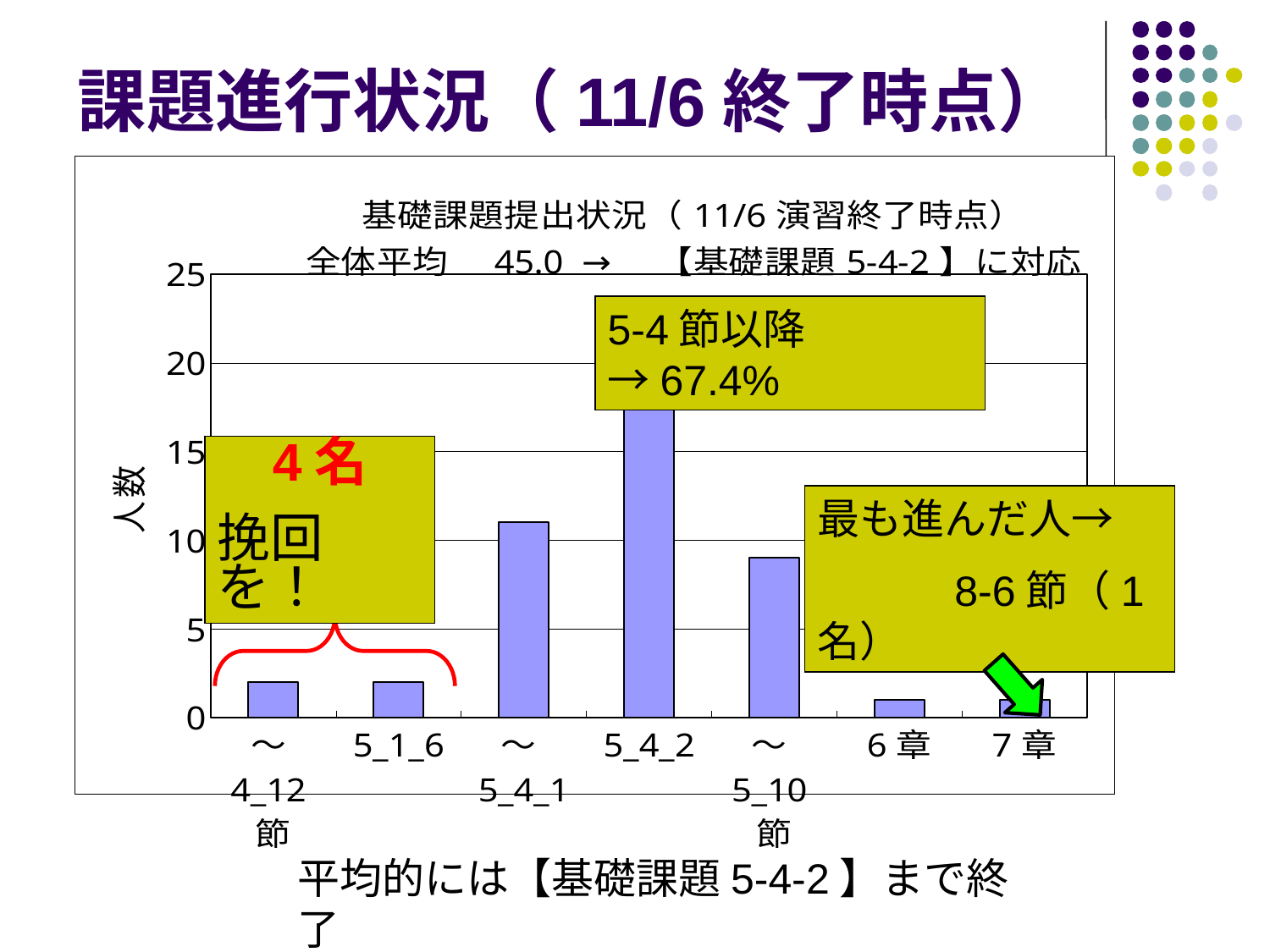
Is the value for 5_1_6 greater or less than 5? less Is the value for 5_4_2 greater or less than 15? greater What is the label of the y axis of the chart? 人数 Is the value for ～5_4_1 greater or less than 5? greater What kind of chart is shown on the slide? bar chart Which is larger, the value for 5_4_2 or the value for ～5_4_1? 5_4_2 How many categories are shown on the x axis of the chart? 7 Which category has the highest bar in the chart? 5_4_2 Which is larger, the value for ～5_4_1 or the value for 5_1_6? ～5_4_1 What overall average (全体平均) is stated in the chart title? 45.0